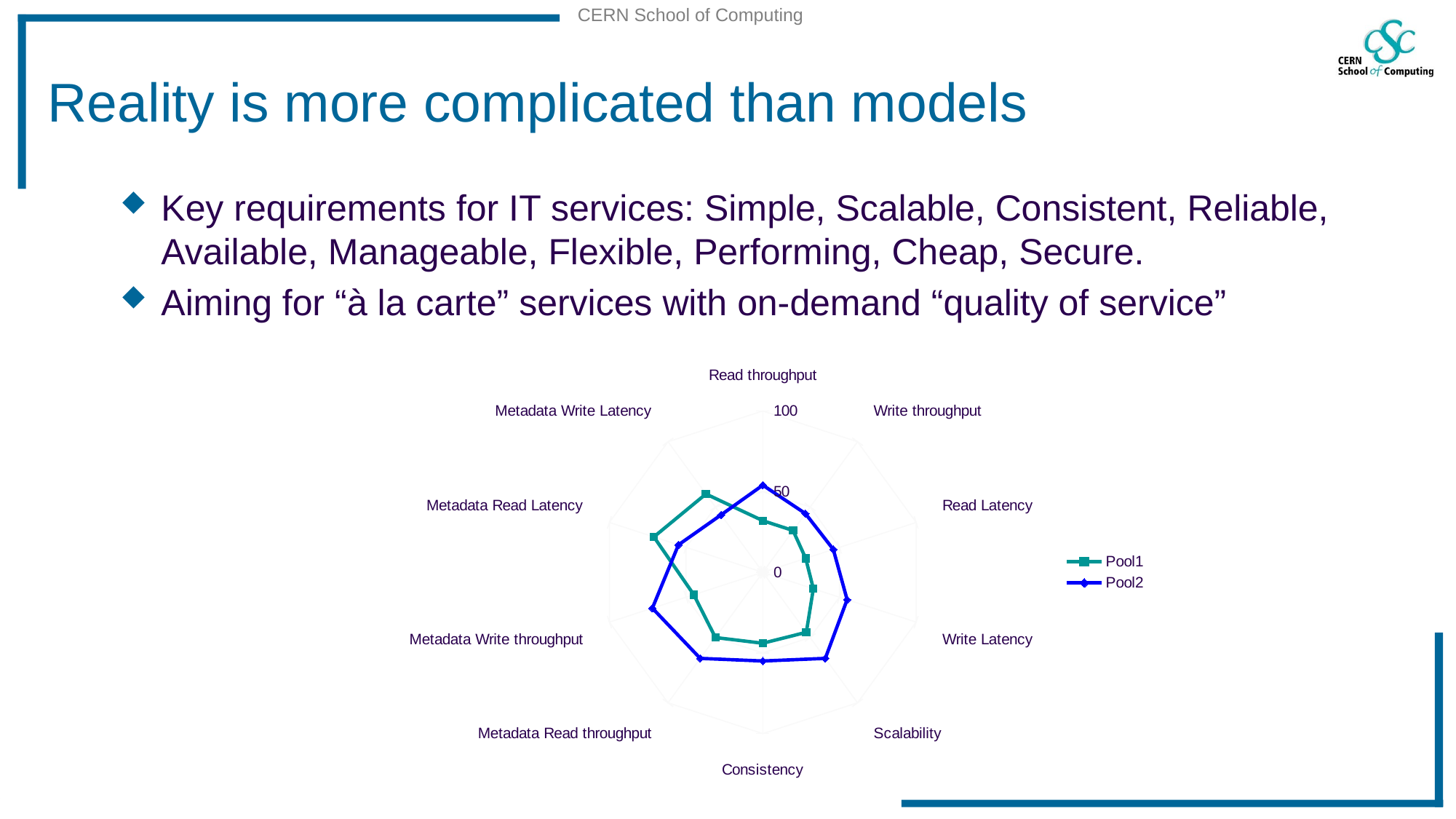
Is the Pool1 value for Read throughput greater or less than 50? less For Metadata Read Latency, which series has the larger value, Pool1 or Pool2? Pool1 Which two series are listed in the chart legend? Pool1 and Pool2 How many series does the chart legend list? 2 Is the Pool1 value for Metadata Read Latency greater or less than 50? greater For Scalability, which series has the larger value, Pool1 or Pool2? Pool2 For Write Latency, which series has the larger value, Pool1 or Pool2? Pool2 How many categories (axes) does the radar chart have? 10 Is the Pool2 value for Metadata Write throughput greater or less than 50? greater What is the highest value shown on the chart's radial axis? 100 What kind of chart is shown on the slide? Radar chart